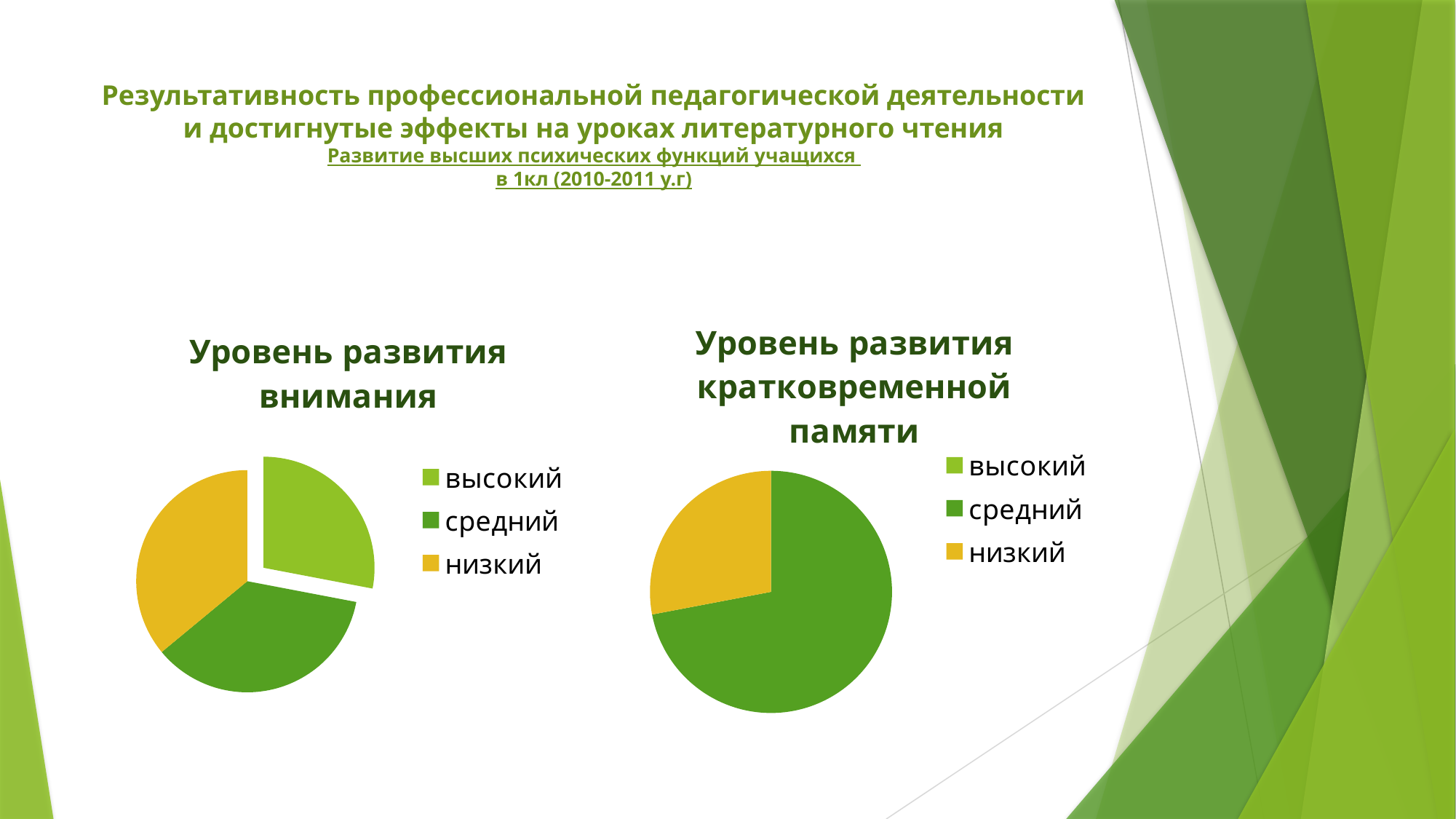
How many entries does the legend of the chart titled "Уровень развития внимания" list? 3 How many entries does the legend of the chart titled "Уровень развития кратковременной памяти" list? 3 In the chart titled "Уровень развития кратковременной памяти", which category has the largest slice? средний What kind of chart is the chart titled "Уровень развития кратковременной памяти"? pie chart In the chart titled "Уровень развития внимания", which slice is larger: средний or высокий? средний In the chart titled "Уровень развития кратковременной памяти", what colour represents the category "низкий"? yellow In the chart titled "Уровень развития внимания", which slice is larger: низкий or высокий? низкий In the chart titled "Уровень развития внимания", which category has the smallest slice? высокий What kind of chart is the chart titled "Уровень развития внимания"? pie chart In the chart titled "Уровень развития кратковременной памяти", which slice is larger: средний or низкий? средний What is the title of the pie chart on the left of the slide? Уровень развития внимания